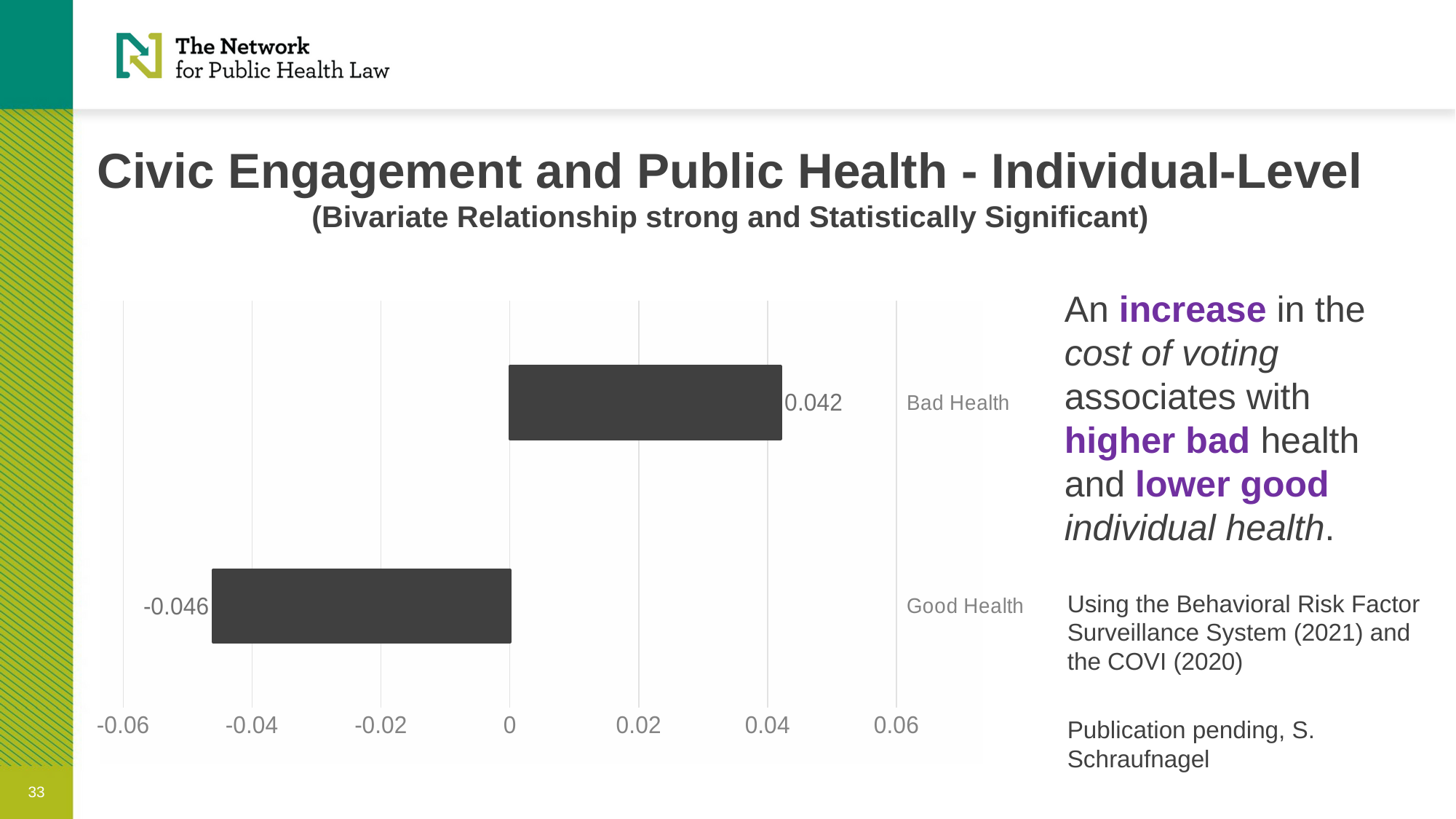
What colour are the bars in the chart? dark grey Which is larger, the value for Bad Health or the value for Good Health? Bad Health What is the minimum value shown on the x axis? -0.06 Which category has the highest value? Bad Health How many categories are shown in the chart? 2 What is the difference between the value for Bad Health and the value for Good Health? 0.088 What is the value for Good Health? -0.046 Which category has the lowest value? Good Health What kind of chart is shown on the slide? bar chart Is the value for Good Health greater or less than -0.02? less What is the value for Bad Health? 0.042 Is the value for Bad Health greater or less than 0.02? greater